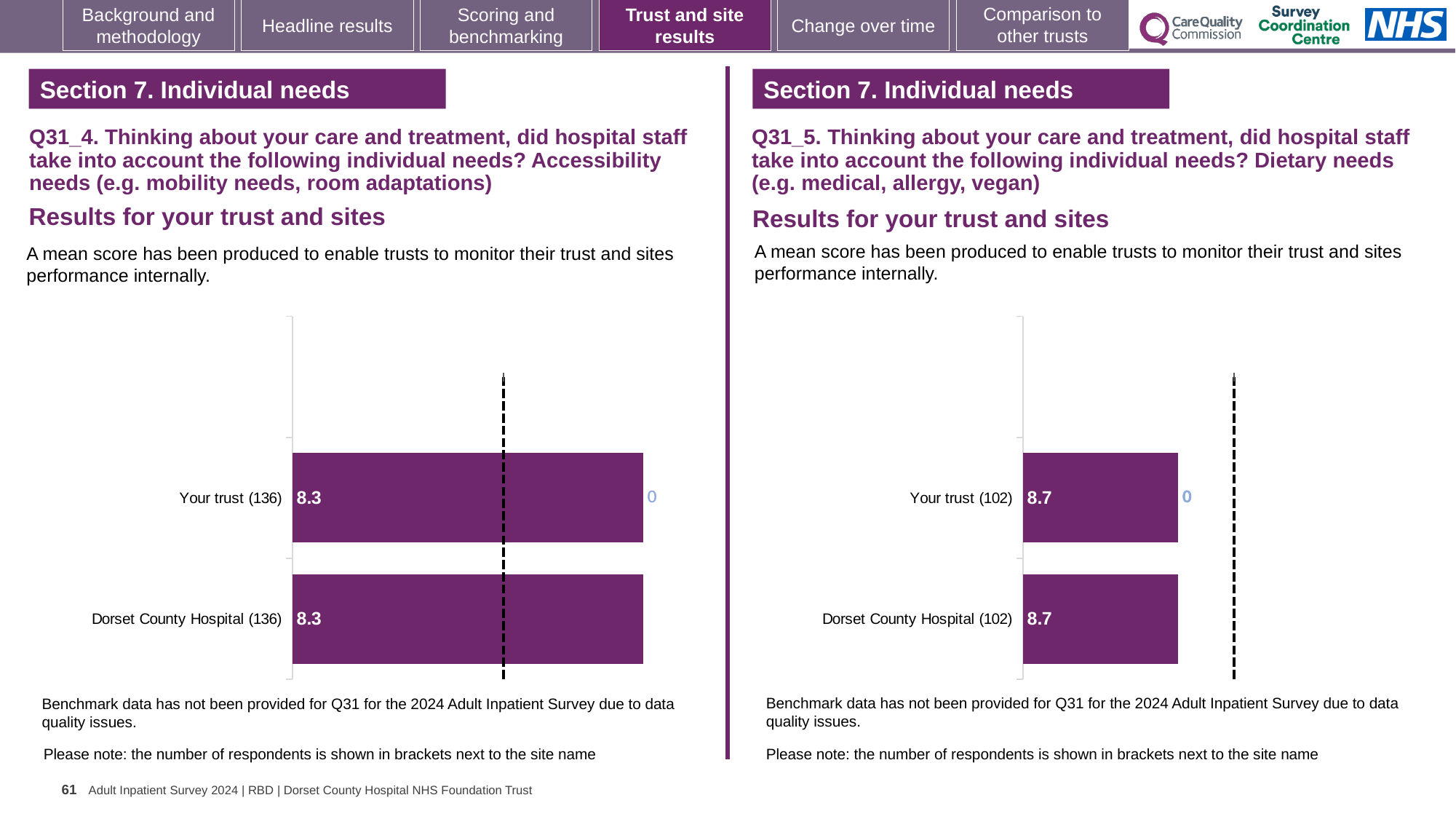
In the Q31_5 chart on the right, what is the difference between the mean score for Your trust and the mean score for Dorset County Hospital? 0 In the Q31_5 chart on the right (Dietary needs), what is the mean score for Your trust? 8.7 How many bars are plotted in the Q31_5 chart on the right? 2 In the Q31_4 chart on the left (Accessibility needs), what is the mean score for Dorset County Hospital? 8.3 In the Q31_5 chart on the right (Dietary needs), what is the mean score for Dorset County Hospital? 8.7 In the Q31_4 chart on the left, how many respondents are shown in brackets next to Your trust? 136 In the Q31_5 chart on the right, how many respondents are shown in brackets next to Dorset County Hospital? 102 Is the mean score for Your trust in the Q31_5 chart on the right higher or lower than the mean score for Your trust in the Q31_4 chart on the left? Higher What kind of chart is used in the Q31_4 chart on the left? Bar chart In the Q31_4 chart on the left, what is the difference between the mean score for Your trust and the mean score for Dorset County Hospital? 0 How many bars are plotted in the Q31_4 chart on the left? 2 In the Q31_4 chart on the left (Accessibility needs), what is the mean score for Your trust? 8.3